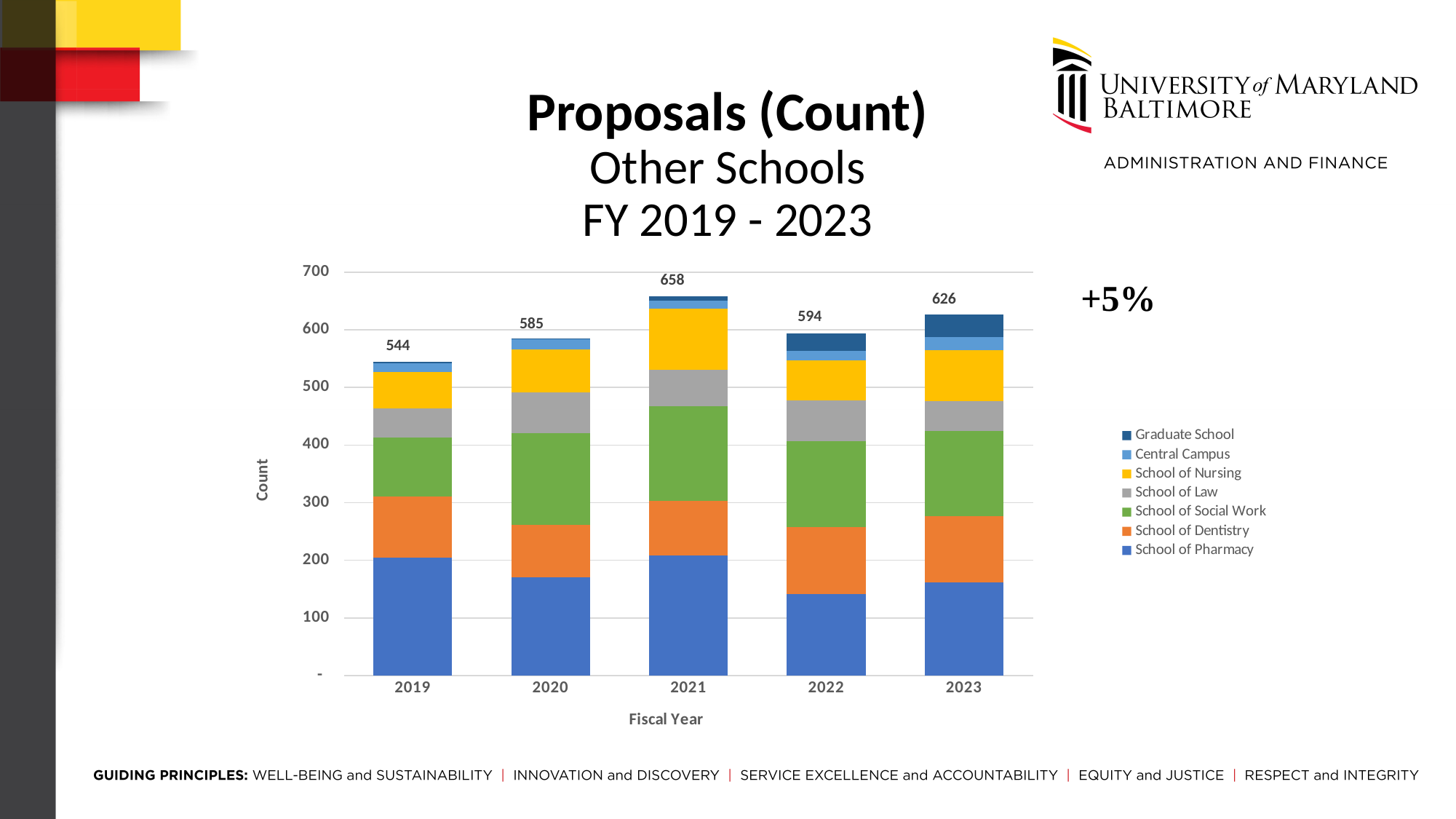
What kind of chart is shown on the slide? Stacked bar chart Which fiscal year has the highest total proposal count? 2021 Which fiscal year has the lowest total proposal count? 2019 How many series does the legend list? 7 Did the total proposal count rise or fall from 2021 to 2022? Fall What is the difference between the total proposal counts for 2023 and 2022? 32 What is the difference between the total proposal counts for 2021 and 2019? 114 What is the total proposal count for fiscal year 2019? 544 How many fiscal years are shown on the x axis? 5 What is the total proposal count for fiscal year 2021? 658 Is the School of Pharmacy value for 2022 greater or less than 200? less Which fiscal year has a larger total proposal count, 2020 or 2022? 2022